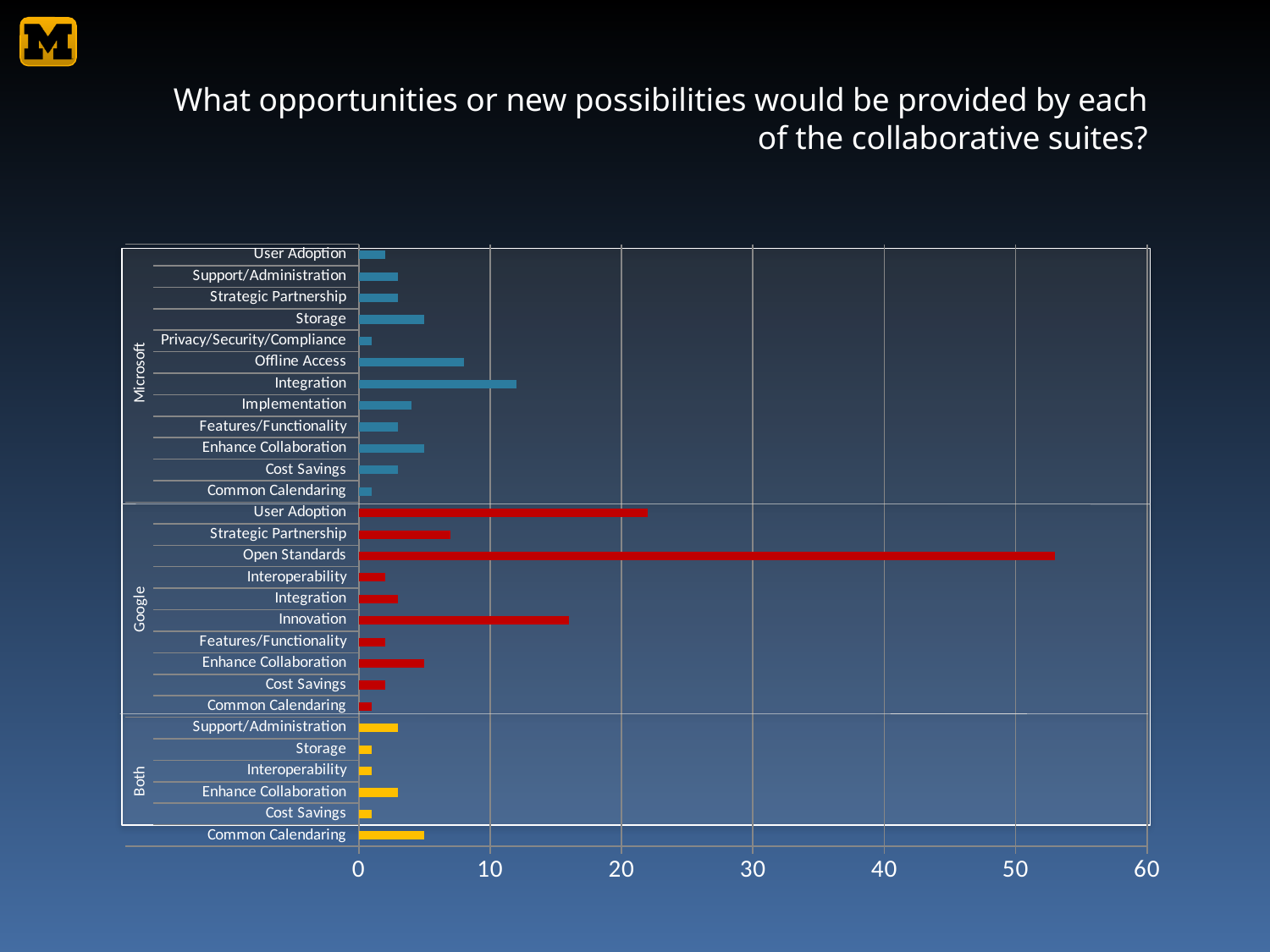
Within the Both group, which category has the highest value? Common Calendaring Is the value for Open Standards in the Google group greater or less than 50? greater Which is larger: User Adoption for Google or User Adoption for Microsoft? User Adoption for Google Is the value for Integration in the Microsoft group greater or less than 10? greater How many categories are listed in the Microsoft group? 12 Is the value for Offline Access in the Microsoft group greater or less than 10? less Within the Microsoft group, which category has the highest value? Integration What kind of chart is shown on the slide? bar chart What are the three groups into which the bars are divided? Microsoft, Google, Both Which category has the longest bar in the whole chart? Open Standards (Google)